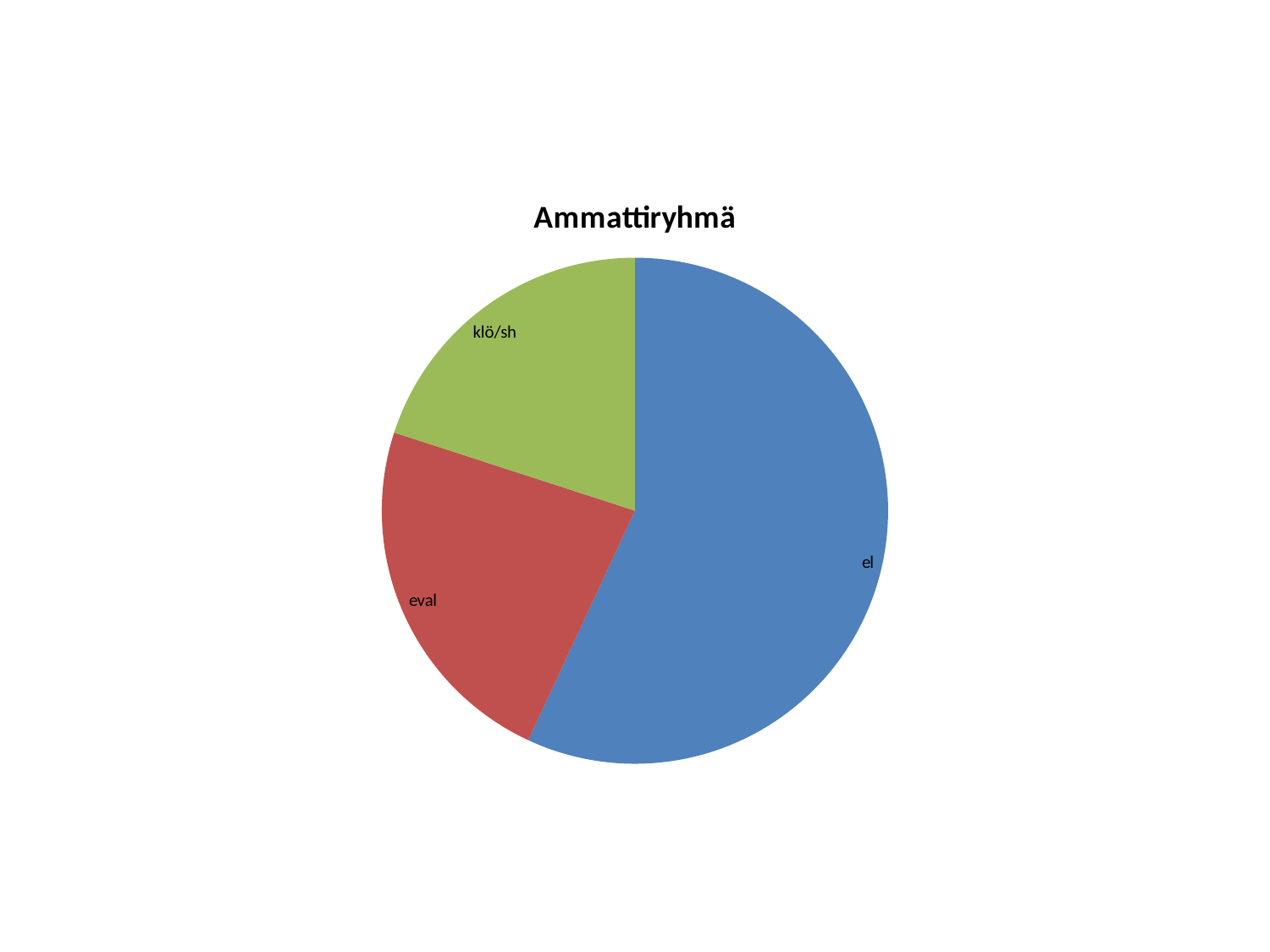
What kind of chart is shown on the slide? pie chart What is the title of the chart? Ammattiryhmä Which slice is larger, el or eval? el Does the el slice take up more or less than half of the pie? more How many slices does the pie chart have? 3 Which slice is larger, eval or klö/sh? eval Which category has the smallest slice of the pie? klö/sh What colour is the el slice? blue Which category has the largest slice of the pie? el